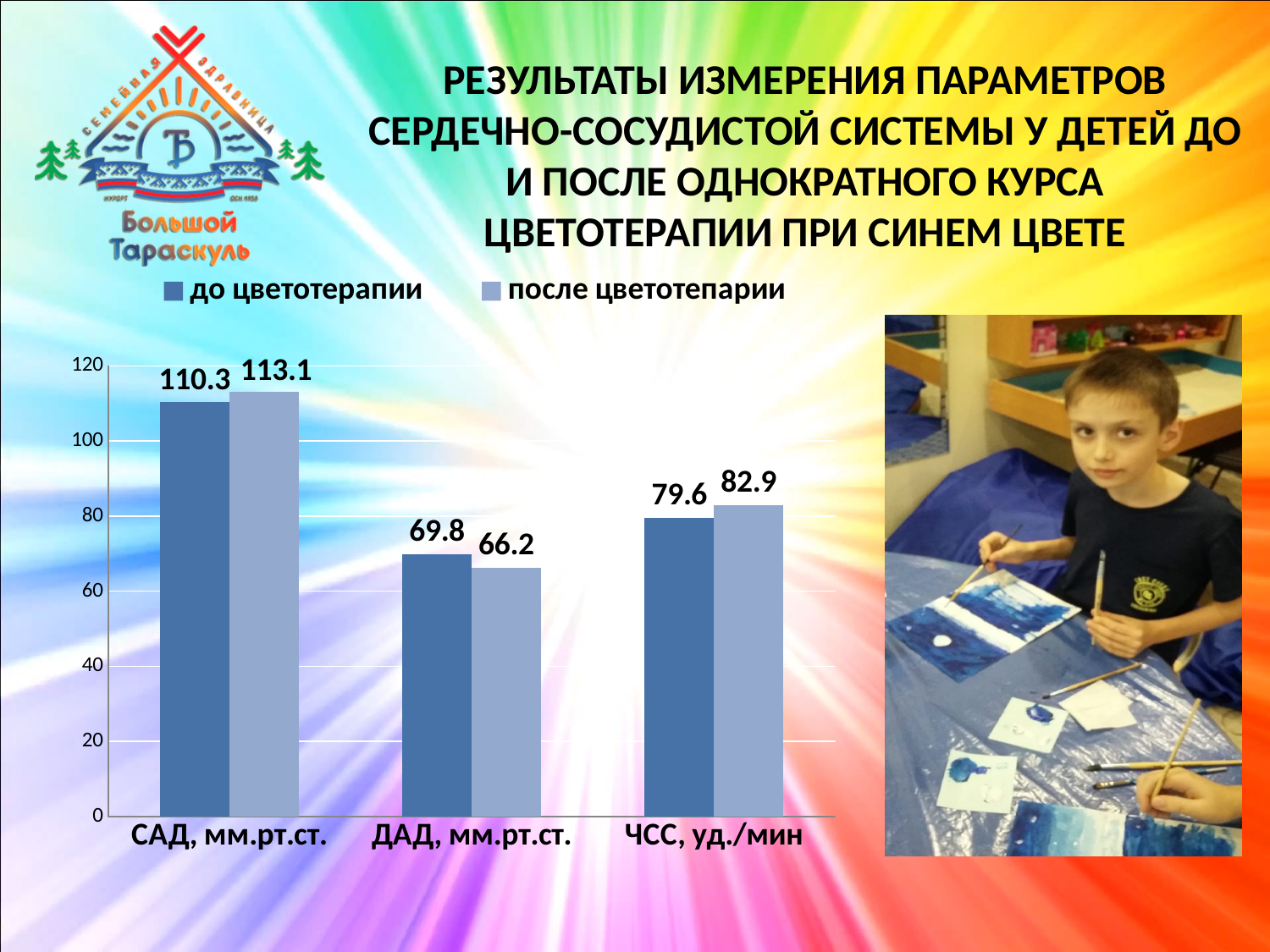
What is the difference between the 'после цветотепарии' and 'до цветотерапии' values for ЧСС, уд./мин? 3.3 What is the value for САД, мм.рт.ст. in the 'до цветотерапии' series? 110.3 What is the difference between the 'до цветотерапии' and 'после цветотепарии' values for ДАД, мм.рт.ст.? 3.6 How many categories are shown on the x axis of the chart? 3 What is the value for ЧСС, уд./мин in the 'до цветотерапии' series? 79.6 Which category has the highest value in the 'после цветотепарии' series? САД, мм.рт.ст. Which category has the lowest value in the 'до цветотерапии' series? ДАД, мм.рт.ст. For САД, мм.рт.ст., which series has the larger value: 'до цветотерапии' or 'после цветотепарии'? после цветотепарии How many series does the legend list? 2 Is the 'до цветотерапии' value for ДАД, мм.рт.ст. greater or less than 80? less What kind of chart is shown on the slide? bar chart What is the value for ДАД, мм.рт.ст. in the 'после цветотепарии' series? 66.2